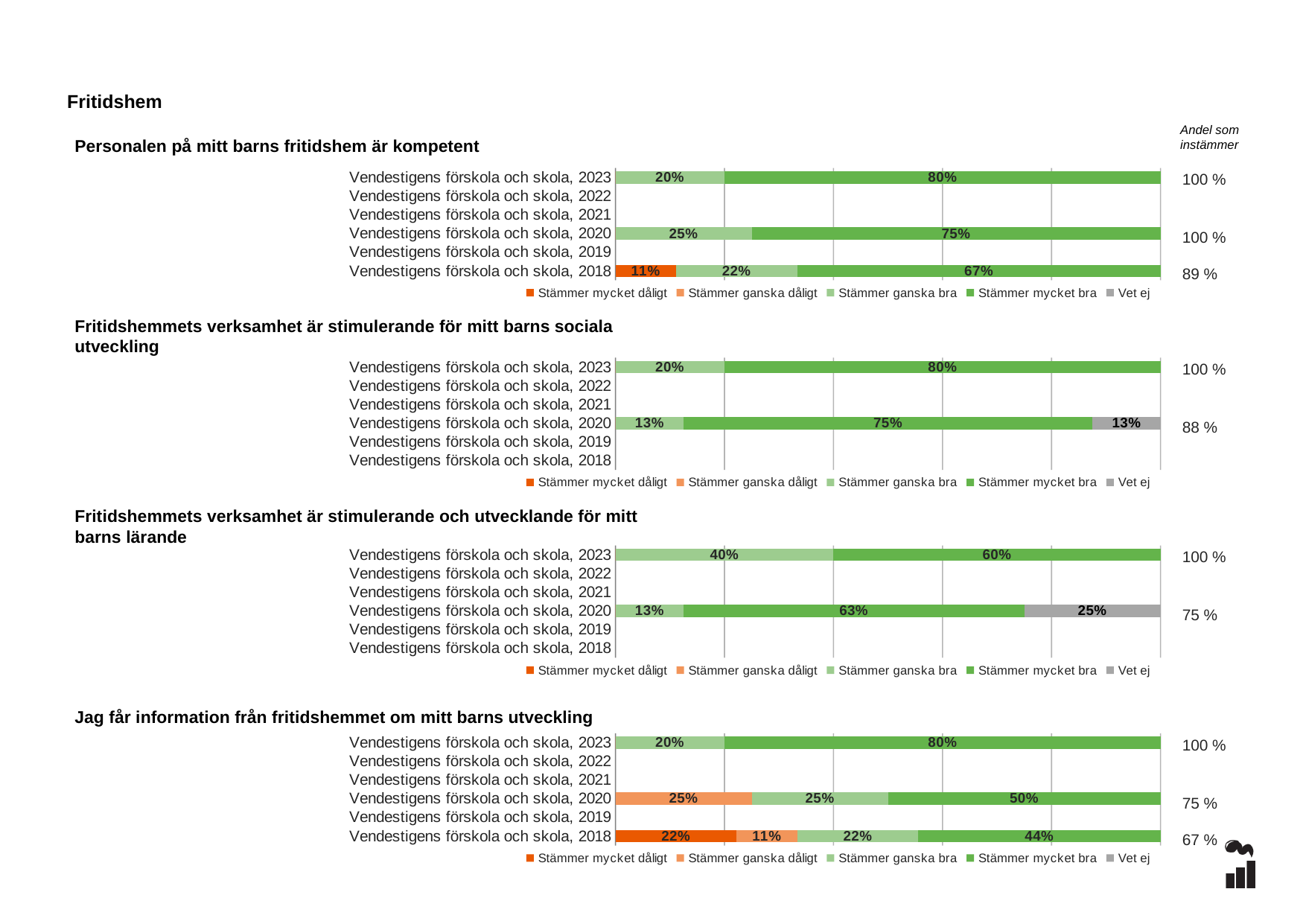
In the chart 'Personalen på mitt barns fritidshem är kompetent', what is the 'Andel som instämmer' for Vendestigens förskola och skola, 2018? 89 % In the chart 'Fritidshemmets verksamhet är stimulerande och utvecklande för mitt barns lärande', what is the difference between the 'Stämmer mycket bra' values for 2023 and 2020? 3 percentage points How many year categories are listed on the y axis of the chart 'Jag får information från fritidshemmet om mitt barns utveckling'? 6 How many series does the legend list in the chart 'Personalen på mitt barns fritidshem är kompetent'? 5 In the chart 'Fritidshemmets verksamhet är stimulerande och utvecklande för mitt barns lärande', what is the 'Stämmer ganska bra' value for Vendestigens förskola och skola, 2023? 40% In the chart 'Jag får information från fritidshemmet om mitt barns utveckling', is the 'Stämmer mycket bra' value larger for 2023 or 2018? 2023 In the chart 'Fritidshemmets verksamhet är stimulerande för mitt barns sociala utveckling', what is the 'Vet ej' value for Vendestigens förskola och skola, 2020? 13% In the chart 'Personalen på mitt barns fritidshem är kompetent', what is the 'Stämmer mycket bra' value for Vendestigens förskola och skola, 2023? 80% What kind of chart is 'Fritidshemmets verksamhet är stimulerande för mitt barns sociala utveckling'? Stacked bar chart In the chart 'Jag får information från fritidshemmet om mitt barns utveckling', which year has the lowest 'Andel som instämmer'? 2018 In the chart 'Personalen på mitt barns fritidshem är kompetent', what is the 'Stämmer mycket dåligt' value for Vendestigens förskola och skola, 2018? 11% In the chart 'Jag får information från fritidshemmet om mitt barns utveckling', what is the 'Stämmer ganska dåligt' value for Vendestigens förskola och skola, 2020? 25%